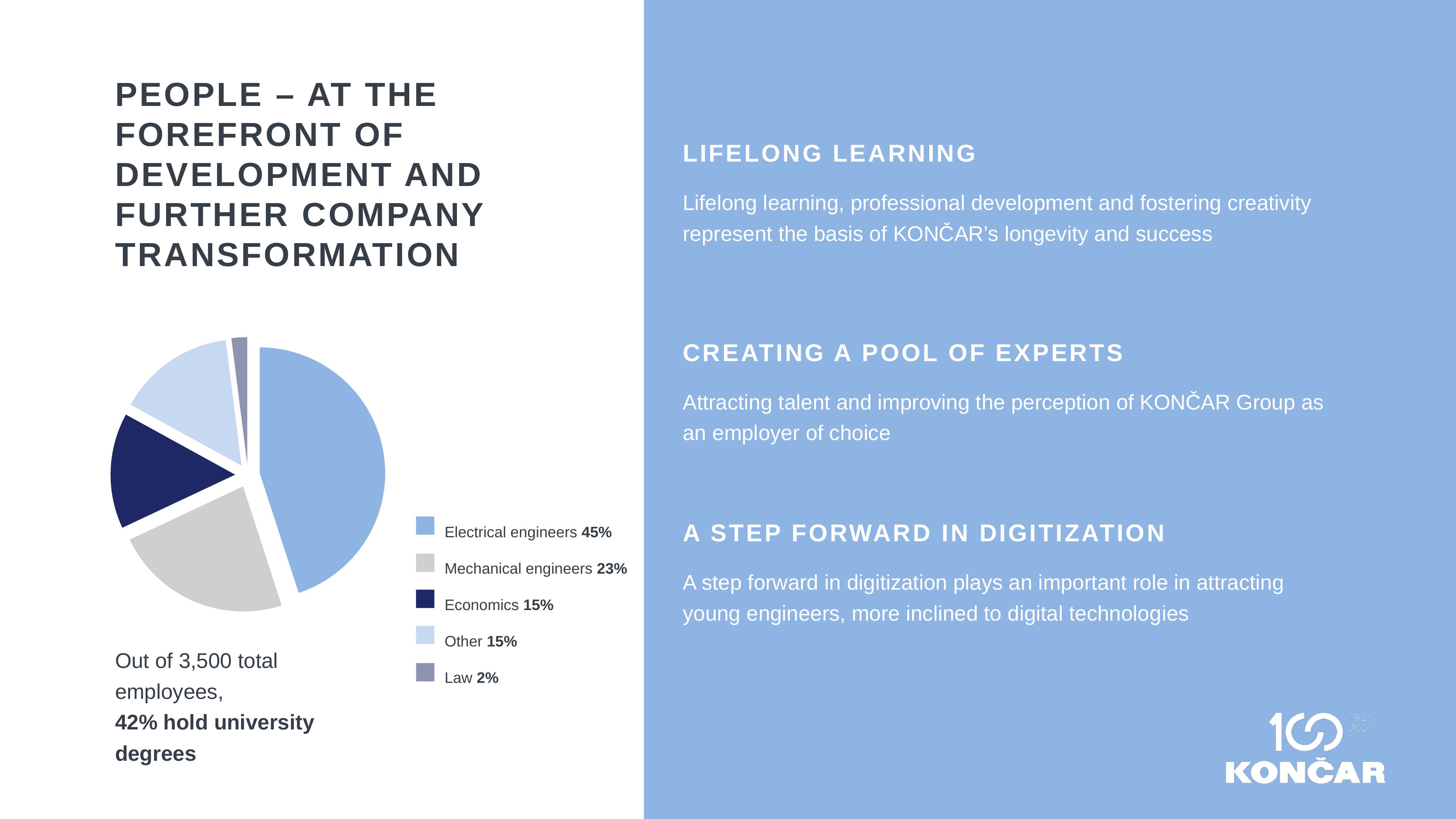
Which category has the largest slice of the pie? Electrical engineers What share of the pie is Economics? 15% Which category is shown in the darkest blue colour in the legend? Economics What share of the pie is Electrical engineers? 45% What share of the pie is Mechanical engineers? 23% How many categories does the pie chart show? 5 What kind of chart is shown on the slide? pie chart What is the combined share of Economics and Other? 30% What is the difference between the Electrical engineers share and the Mechanical engineers share? 22% Which category has the smallest slice of the pie? Law Which is larger, the Mechanical engineers share or the Economics share? Mechanical engineers